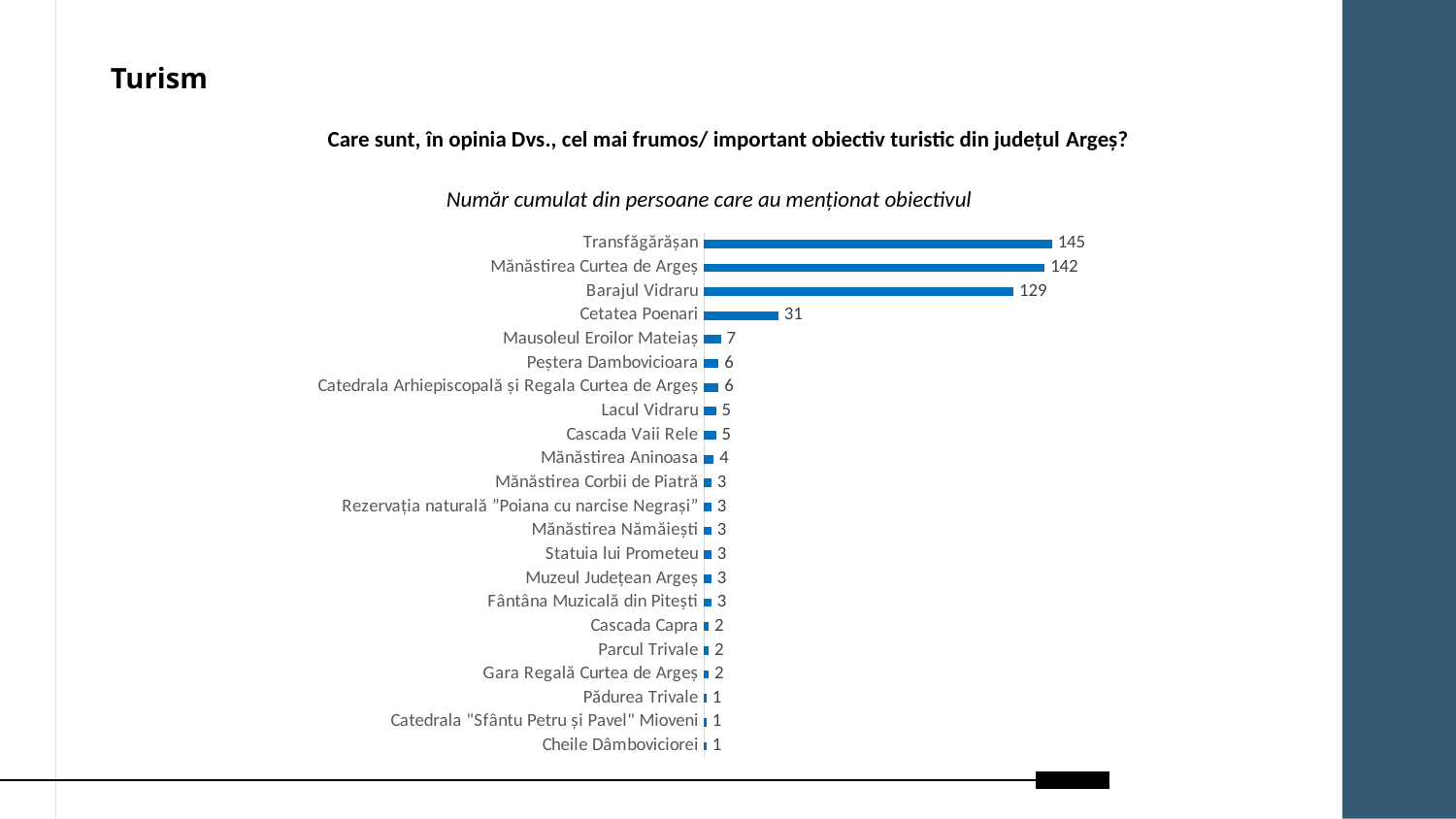
What value is shown for Mausoleul Eroilor Mateiaș? 7 Which is larger, the value for Cetatea Poenari or the value for Peștera Dambovicioara? Cetatea Poenari What is the subtitle shown in italics above the chart? Număr cumulat din persoane care au menționat obiectivul What value is shown for Cetatea Poenari? 31 What is the difference between the values for Transfăgărășan and Mănăstirea Curtea de Argeș? 3 Which is larger, the value for Lacul Vidraru or the value for Mănăstirea Aninoasa? Lacul Vidraru What value is shown for Transfăgărășan? 145 What is the difference between the values for Barajul Vidraru and Cetatea Poenari? 98 How many categories are shown in the chart? 22 What value is shown for Barajul Vidraru? 129 Which category has the highest value? Transfăgărășan What kind of chart is shown on the slide? Bar chart